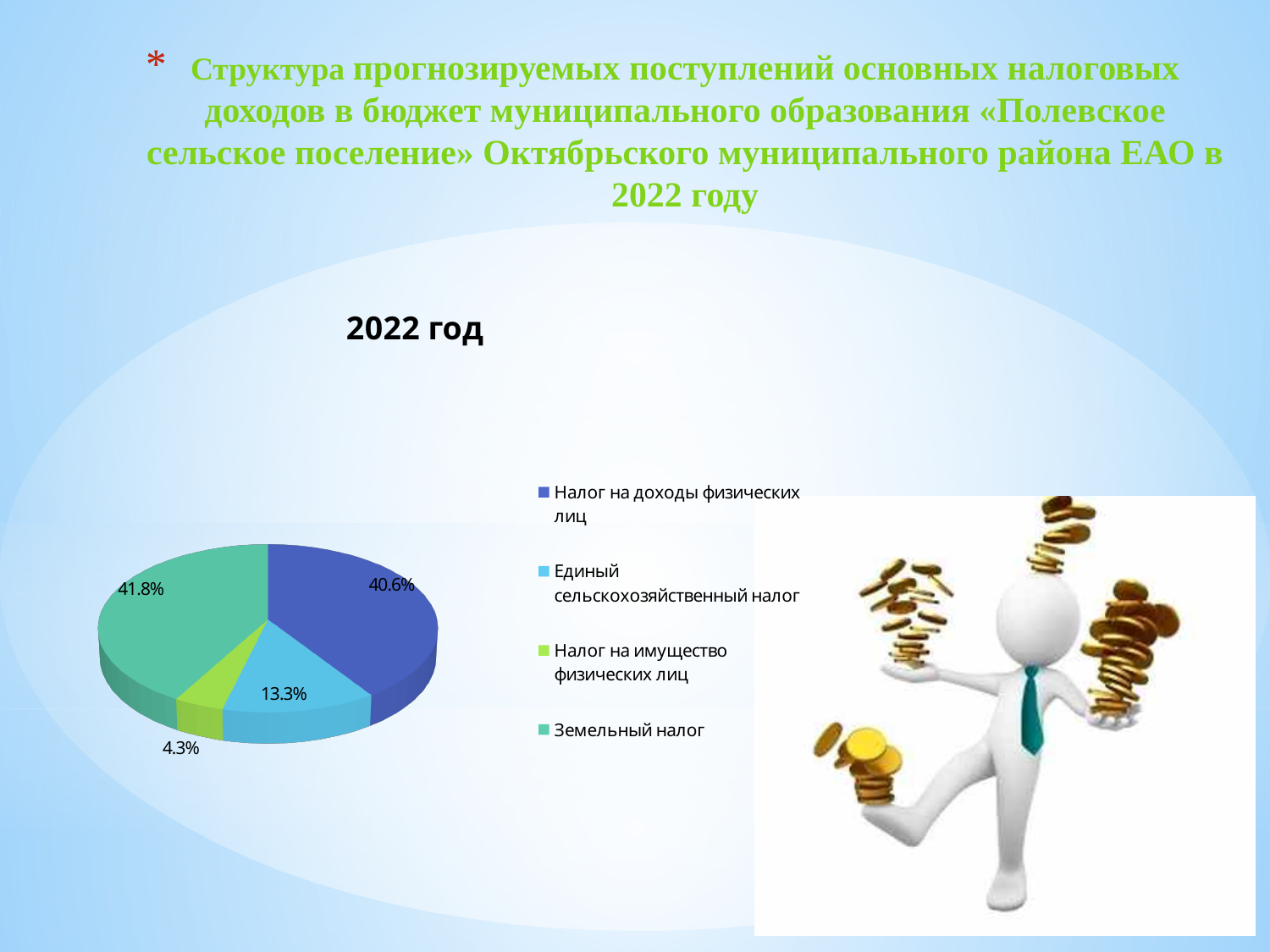
What is the title of the chart? 2022 год What kind of chart is shown on the slide? pie chart What share of the pie does Налог на доходы физических лиц have? 40.6% What share of the pie does Земельный налог have? 41.8% What is the difference between the shares of Земельный налог and Налог на доходы физических лиц? 1.2% What share of the pie does Налог на имущество физических лиц have? 4.3% Which category has the largest share of the pie? Земельный налог Which is larger, the share of Единый сельскохозяйственный налог or the share of Налог на имущество физических лиц? Единый сельскохозяйственный налог Which category has the smallest share of the pie? Налог на имущество физических лиц What share of the pie does Единый сельскохозяйственный налог have? 13.3% How many slices does the pie chart have? 4 How many entries does the legend list? 4